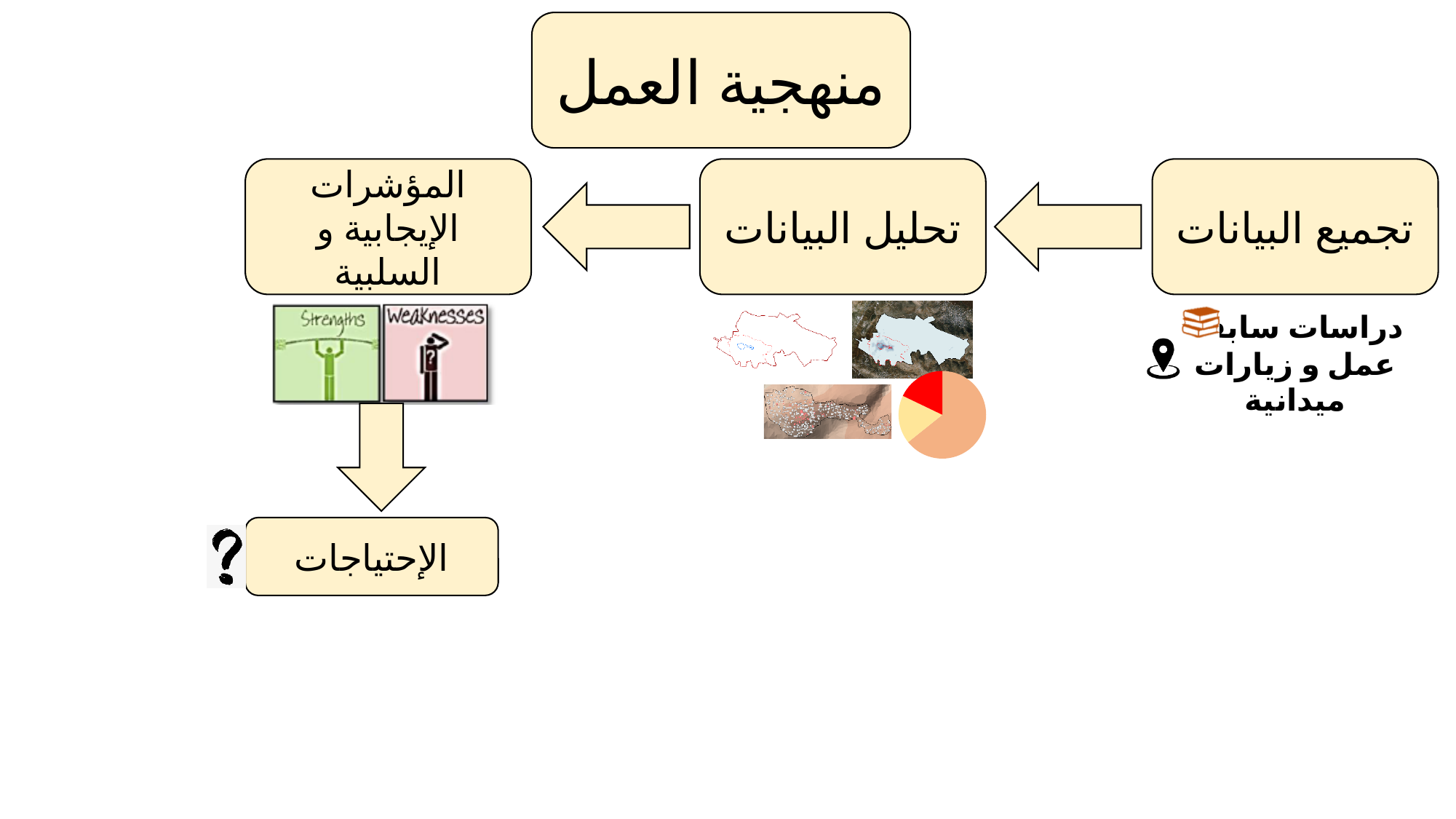
How many slices does the pie chart have? 3 Does the orange slice of the pie chart take up more or less than half of the pie? more Does the pie chart have a legend? no Is the orange slice of the pie chart larger than the red slice? yes What colours are the slices of the pie chart? red, yellow and orange Which slice of the pie chart is the largest? the orange (peach) slice What kind of chart is shown on the slide? pie chart